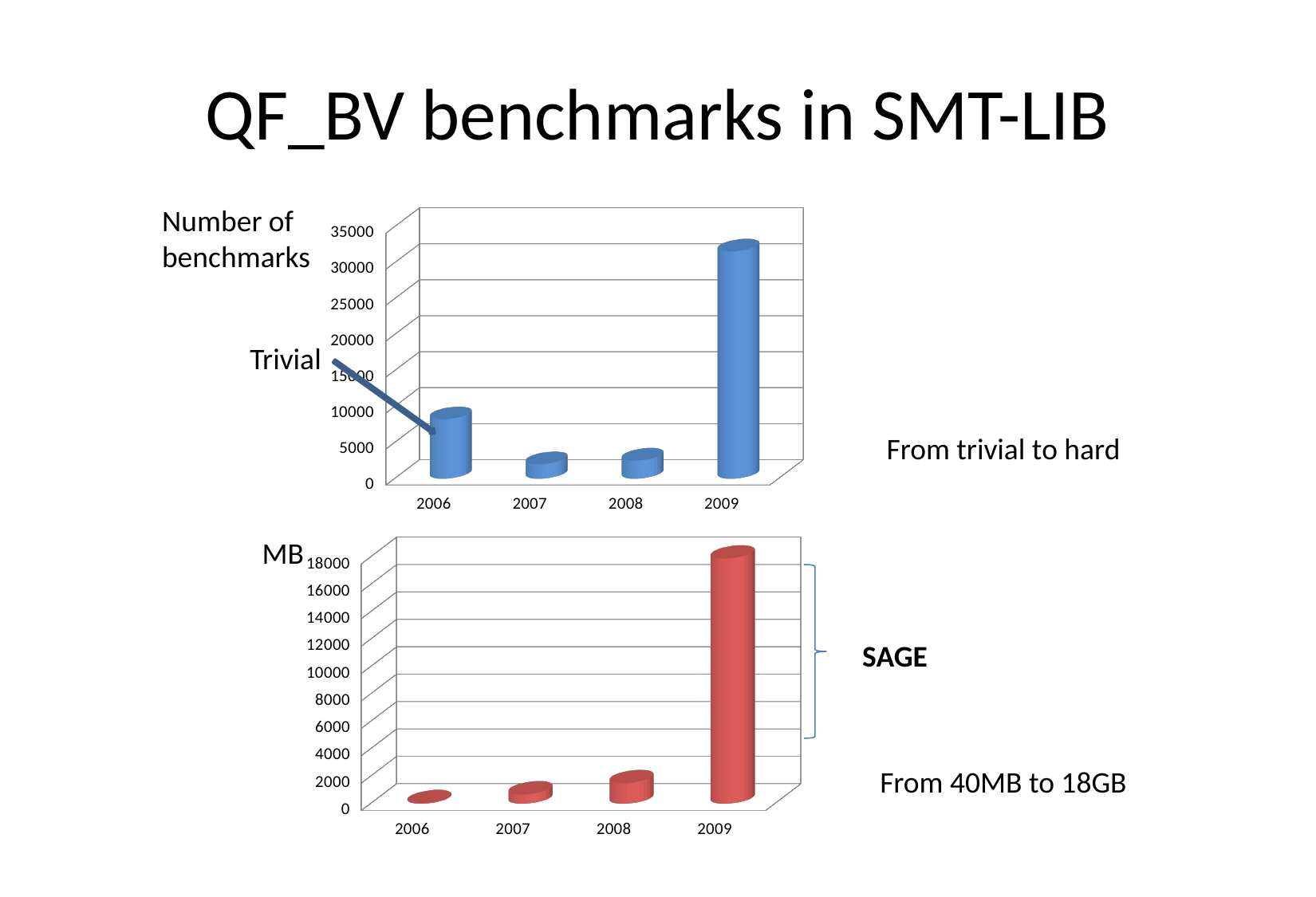
In the top chart (Number of benchmarks), which is larger, the value for 2006 or the value for 2007? 2006 In the bottom chart (MB), which year has the highest value? 2009 What kind of chart is the top chart (Number of benchmarks)? bar chart In the bottom chart (MB), is the value for 2009 greater or less than 16000? greater In the top chart (Number of benchmarks), which year has the highest number of benchmarks? 2009 How many years are shown on the x axis of the top chart (Number of benchmarks)? 4 In the bottom chart (MB), do the values rise or fall from 2006 to 2009? rise What colour are the bars in the bottom chart (MB)? red In the top chart (Number of benchmarks), is the value for 2009 greater or less than 25000? greater In the bottom chart (MB), which year has the lowest value? 2006